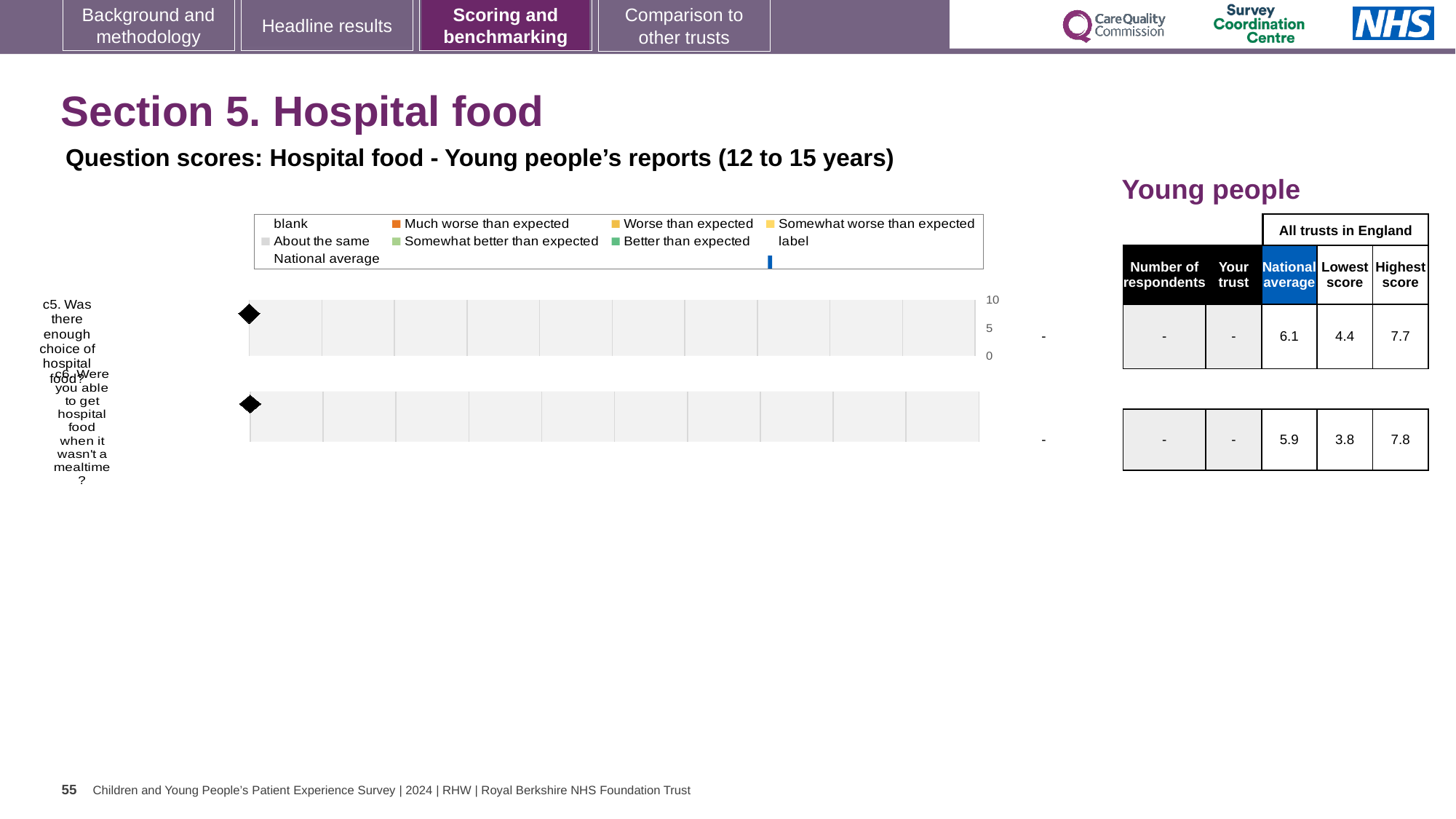
What is the lowest score across all trusts in England for c6 'Were you able to get hospital food when it wasn't a mealtime?' 3.8 What is the lowest score across all trusts in England for c5 'Was there enough choice of hospital food?' 4.4 What is the 'Your trust' score shown for c5 'Was there enough choice of hospital food?' - Which question has the higher 'Highest score' value, c5 or c6? c6 What is the difference between the highest and lowest scores for c5 'Was there enough choice of hospital food?' 3.3 What kind of chart is used for the question scores on hospital food? bar chart How many questions (categories) are shown in the hospital food chart? 2 What is the difference between the highest and lowest scores for c6 'Were you able to get hospital food when it wasn't a mealtime?' 4.0 What is the highest score across all trusts in England for c6 'Were you able to get hospital food when it wasn't a mealtime?' 7.8 Which question has the higher national average score, c5 or c6? c5 What is the national average score for c5 'Was there enough choice of hospital food?' 6.1 What is the maximum value shown on the chart's score axis? 10